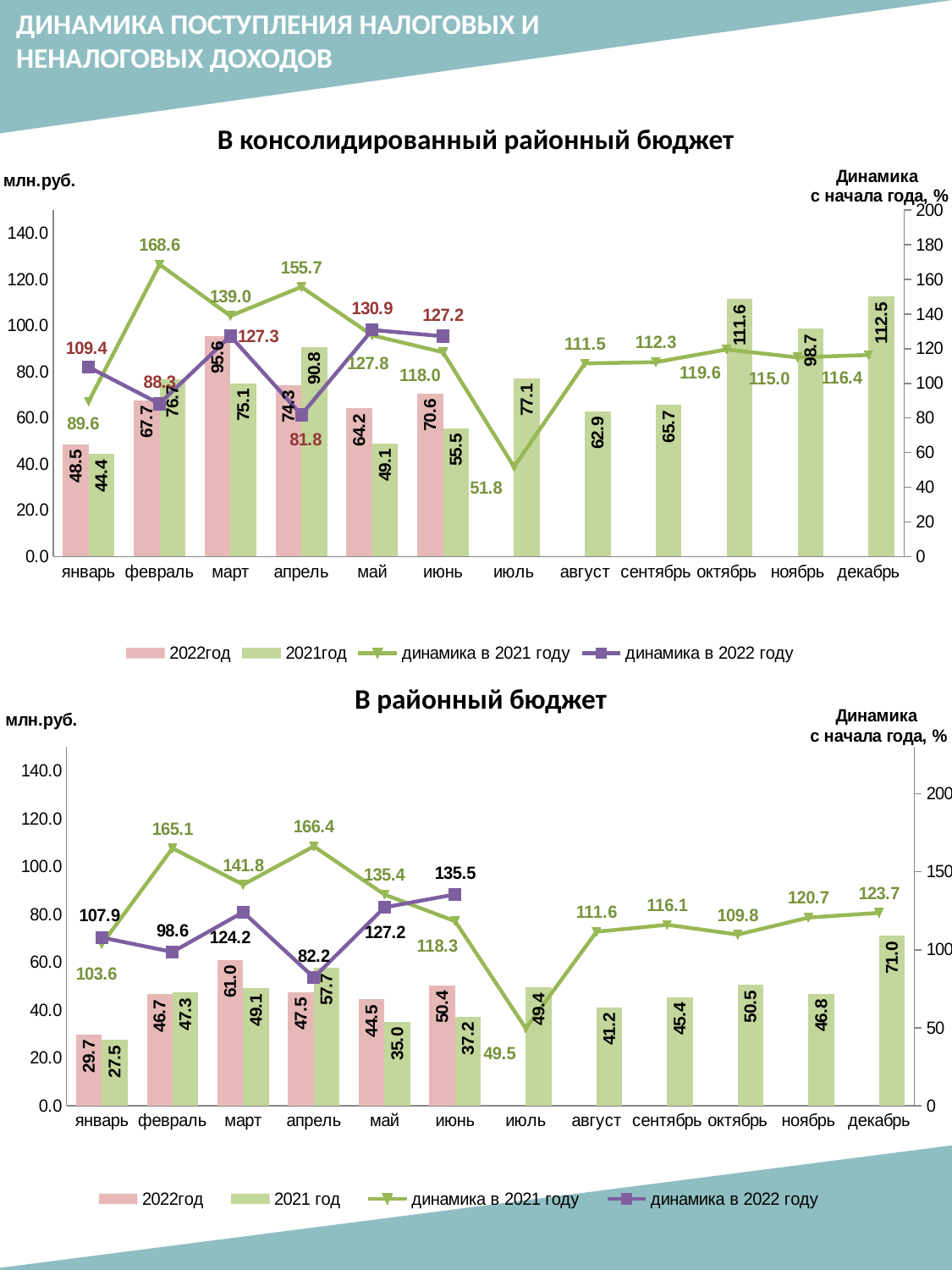
In the chart 'В консолидированный районный бюджет', which month has the lowest value on the 'динамика в 2021 году' line? июль In the chart 'В районный бюджет', what is the value of the 2022год bar for июнь? 50.4 In the chart 'В консолидированный районный бюджет', which month has the highest value on the 'динамика в 2021 году' line? февраль In the chart 'В консолидированный районный бюджет', how many series does the legend list? 4 In the chart 'В консолидированный районный бюджет', what is the difference between the 2022год and 2021год bars for май? 15.1 In the chart 'В консолидированный районный бюджет', what is the value of the 2021год bar for декабрь? 112.5 In the chart 'В районный бюджет', how many months are shown on the x axis? 12 What kind of chart is 'В районный бюджет'? Combined bar and line chart In the chart 'В районный бюджет', which is larger for март: the 2022год bar or the 2021 год bar? 2022год In the chart 'В районный бюджет', which month has the highest 2021 год bar? декабрь In the chart 'В районный бюджет', what is the value of the 'динамика в 2022 году' line for апрель? 82.2 In the chart 'В консолидированный районный бюджет', what is the value of the 2022год bar for март? 95.6